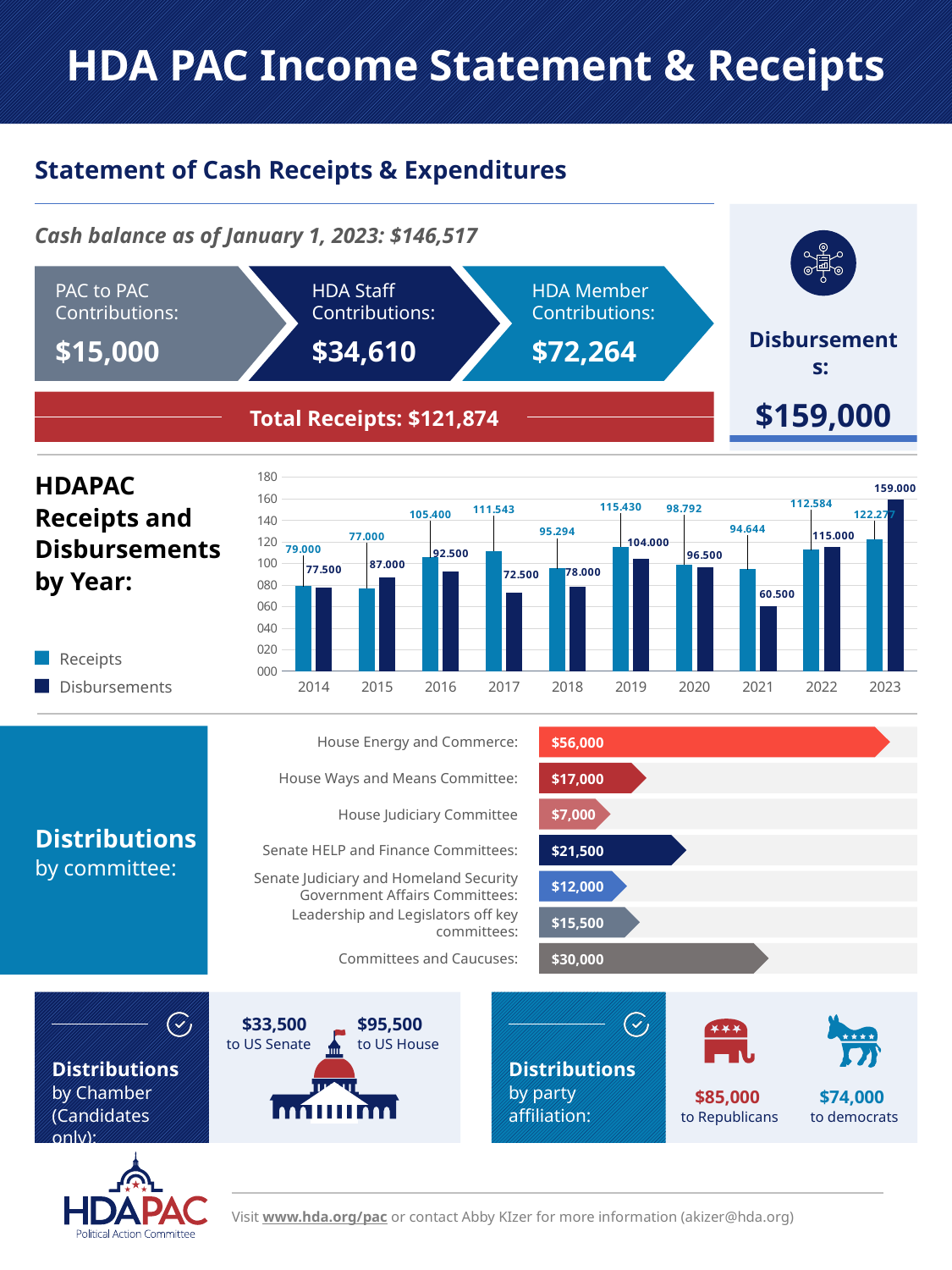
In the 'Distributions by committee' chart, what is the value for Committees and Caucuses? $30,000 In the 'HDAPAC Receipts and Disbursements by Year' chart, what is the Disbursements value for 2021? 60.500 In the 'HDAPAC Receipts and Disbursements by Year' chart, what is the Receipts value for 2017? 111.543 What kind of chart is the 'HDAPAC Receipts and Disbursements by Year' chart? Bar chart In the 'HDAPAC Receipts and Disbursements by Year' chart, which is larger in 2022, Receipts or Disbursements? Disbursements In the 'Distributions by committee' chart, what is the difference between House Energy and Commerce and House Ways and Means Committee? $39,000 How many years are shown on the x axis of the 'HDAPAC Receipts and Disbursements by Year' chart? 10 In the 'Distributions by committee' chart, which committee received the smallest distribution? House Judiciary Committee In the 'HDAPAC Receipts and Disbursements by Year' chart, which year has the lowest Receipts value? 2015 In the 'HDAPAC Receipts and Disbursements by Year' chart, which year has the highest Disbursements value? 2023 In the 'HDAPAC Receipts and Disbursements by Year' chart, what is the difference between Receipts and Disbursements in 2019? 11.430 How many series does the legend of the 'HDAPAC Receipts and Disbursements by Year' chart list? 2